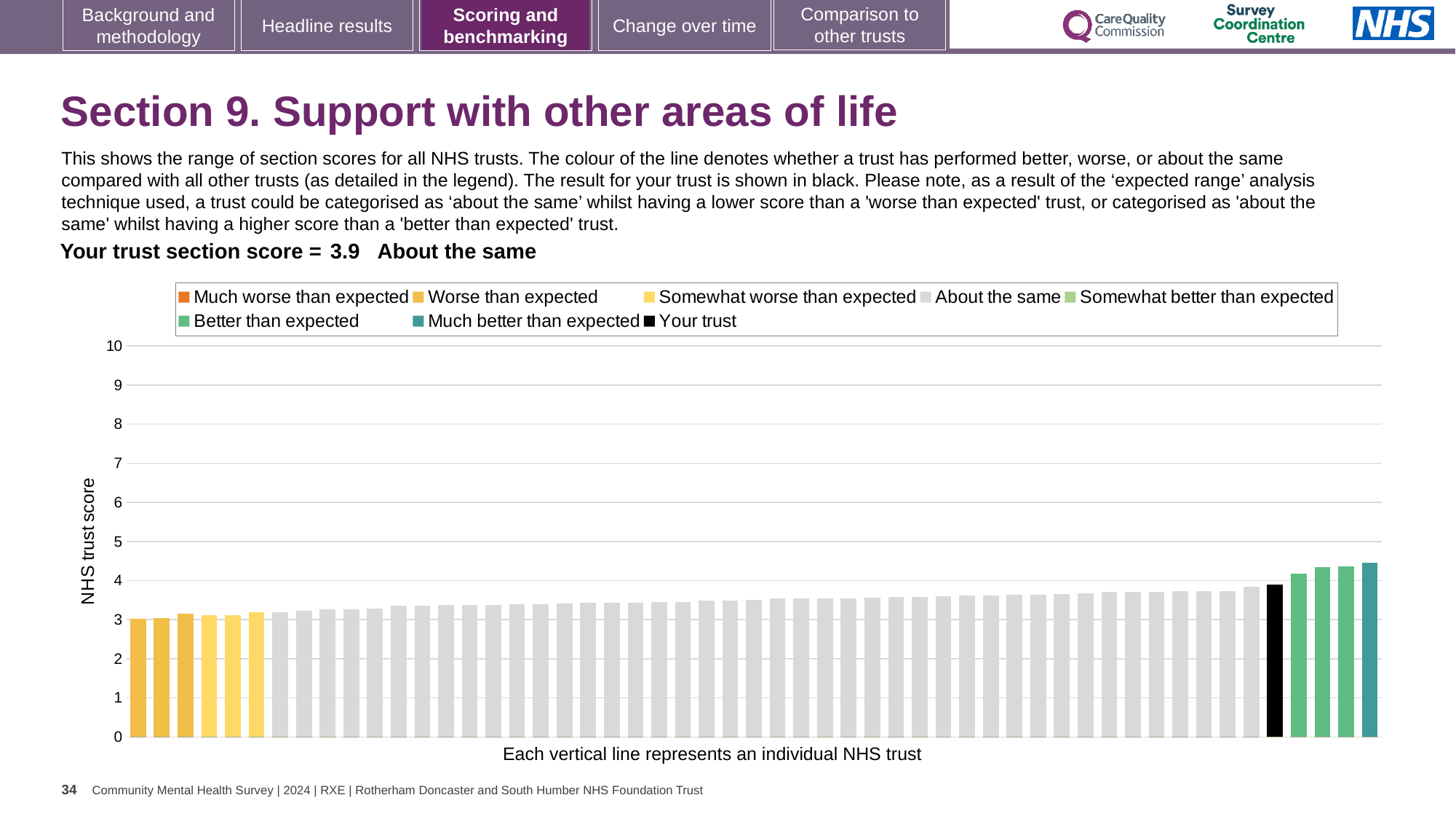
What is the section score for your trust shown on the slide? 3.9 Is the value of the black 'Your trust' bar greater or less than 5? less What kind of chart is shown on the slide? bar chart Which performance category is your trust placed in for this section? About the same Is the value of the black 'Your trust' bar greater or less than 3? greater Which is larger, the leftmost bar or the rightmost bar? the rightmost bar Is the value of the shortest bar (leftmost) greater or less than 4? less What is the label on the vertical axis of the chart? NHS trust score Do the bar values rise or fall moving from left to right along the x axis? rise How many bars are to the right of the black 'Your trust' bar? 4 How many entries does the chart legend list? 8